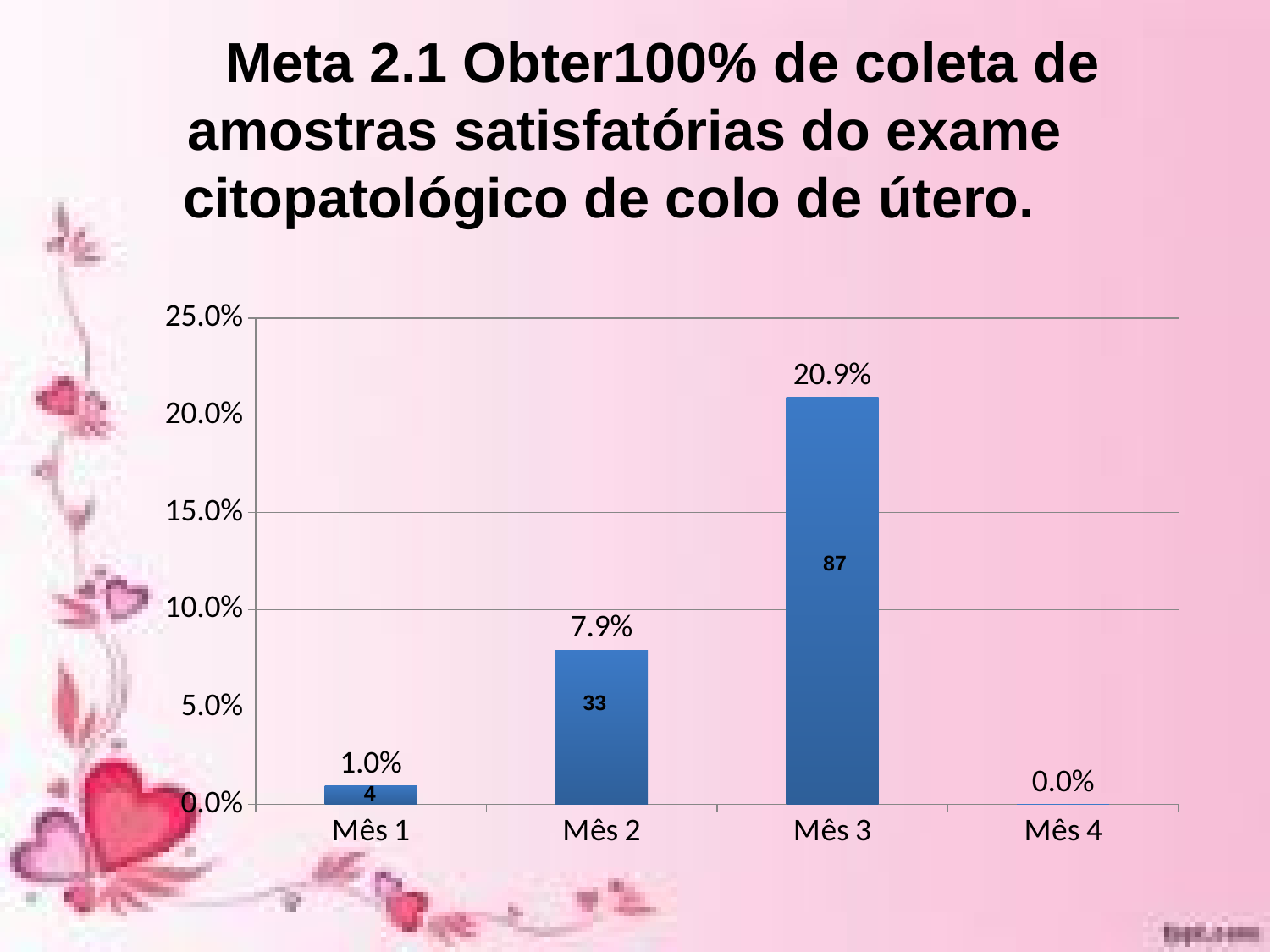
How many months are shown on the x axis? 4 Which month has the lowest value? Mês 4 What is the value for Mês 1? 1.0% What number is printed inside the bar for Mês 3? 87 What is the value for Mês 4? 0.0% What is the value for Mês 2? 7.9% What kind of chart is shown on the slide? bar chart Is the value for Mês 3 greater or less than 20.0%? greater What is the difference between the values for Mês 3 and Mês 2? 13.0% Which is larger, the value for Mês 2 or the value for Mês 1? Mês 2 Which month has the highest value? Mês 3 What is the value for Mês 3? 20.9%